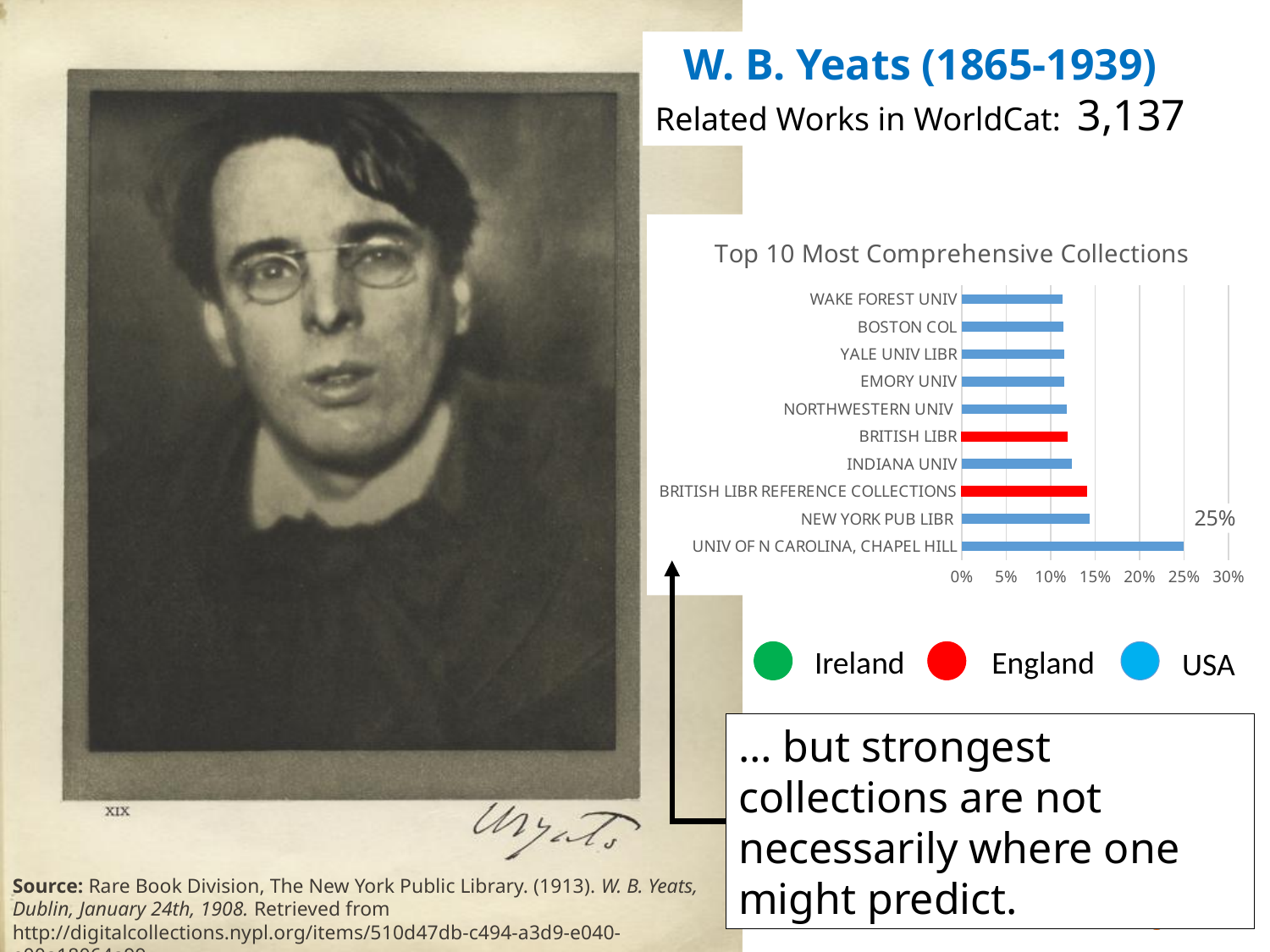
Is the value for NEW YORK PUB LIBR greater or less than 10%? greater How many entries does the legend below the chart list? 3 What is the value for UNIV OF N CAROLINA, CHAPEL HILL in the Top 10 Most Comprehensive Collections chart? 25% Which has a larger value, UNIV OF N CAROLINA, CHAPEL HILL or BOSTON COL? UNIV OF N CAROLINA, CHAPEL HILL How many collections are listed in the Top 10 Most Comprehensive Collections chart? 10 Is the value for BRITISH LIBR REFERENCE COLLECTIONS greater or less than 20%? less Which collection has the highest value in the Top 10 Most Comprehensive Collections chart? UNIV OF N CAROLINA, CHAPEL HILL Which bars in the chart are coloured red? BRITISH LIBR and BRITISH LIBR REFERENCE COLLECTIONS What is the title of the chart on the slide? Top 10 Most Comprehensive Collections What kind of chart is used to show the Top 10 Most Comprehensive Collections? Bar chart Which has a larger value, NEW YORK PUB LIBR or EMORY UNIV? NEW YORK PUB LIBR Is the value for WAKE FOREST UNIV greater or less than 15%? less